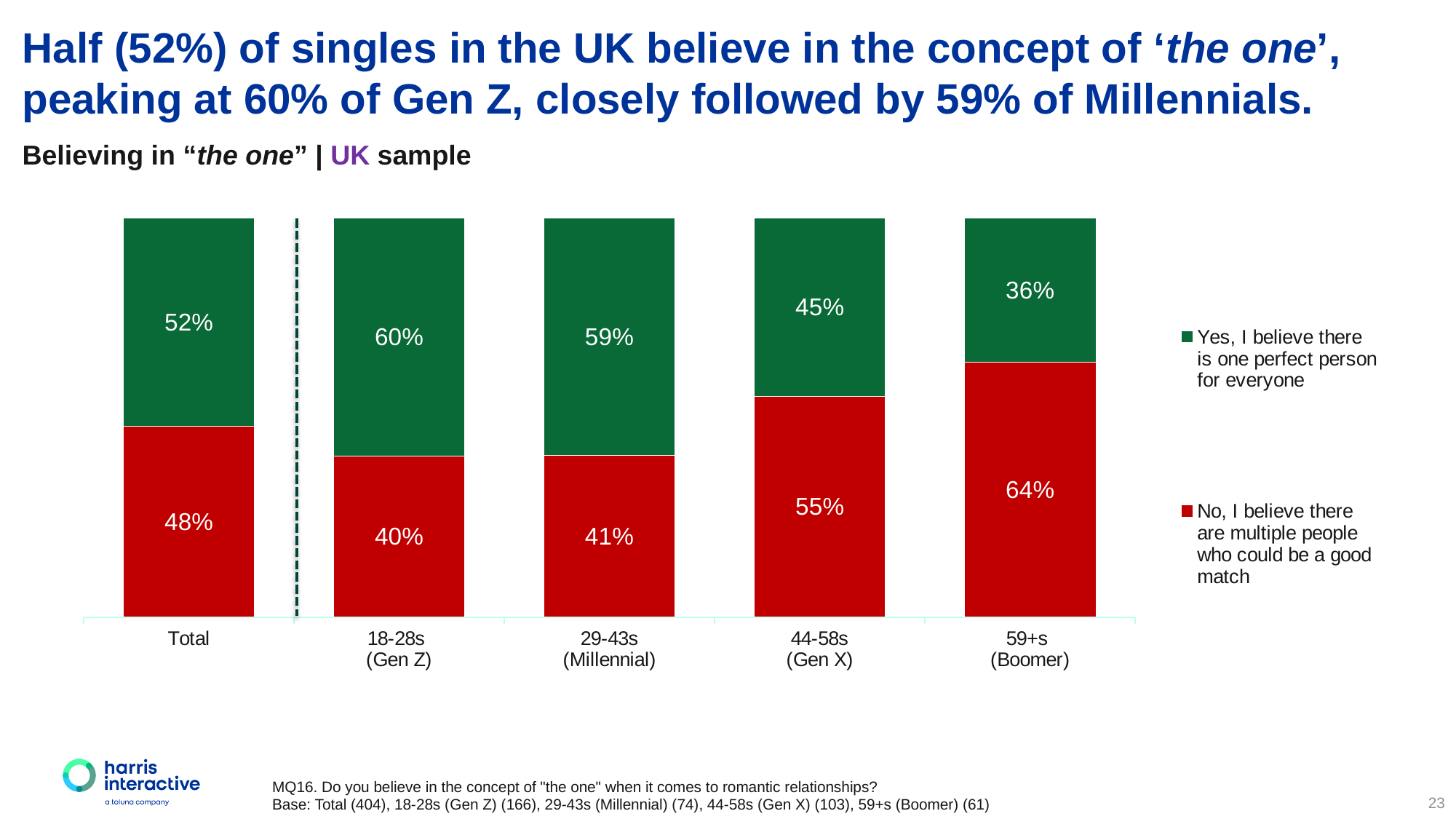
Moving from 18-28s (Gen Z) to 59+s (Boomer), do the 'Yes' values rise or fall? Fall How many series does the legend list? 2 What is the 'Yes' value for 44-58s (Gen X)? 45% What percentage of 59+s (Boomer) said 'No, I believe there are multiple people who could be a good match'? 64% What percentage of the Total sample said 'Yes, I believe there is one perfect person for everyone'? 52% Which age group has the highest 'Yes, I believe there is one perfect person for everyone' value? 18-28s (Gen Z) Which is larger: the 'Yes' value for 29-43s (Millennial) or the 'Yes' value for 44-58s (Gen X)? 29-43s (Millennial) What colour represents 'No, I believe there are multiple people who could be a good match'? Red What is the difference between the 'No' value for 59+s (Boomer) and the 'No' value for 18-28s (Gen Z)? 24% Which age group has the lowest 'Yes, I believe there is one perfect person for everyone' value? 59+s (Boomer) What kind of chart is shown on the slide? Stacked bar chart How many categories are shown on the x axis? 5